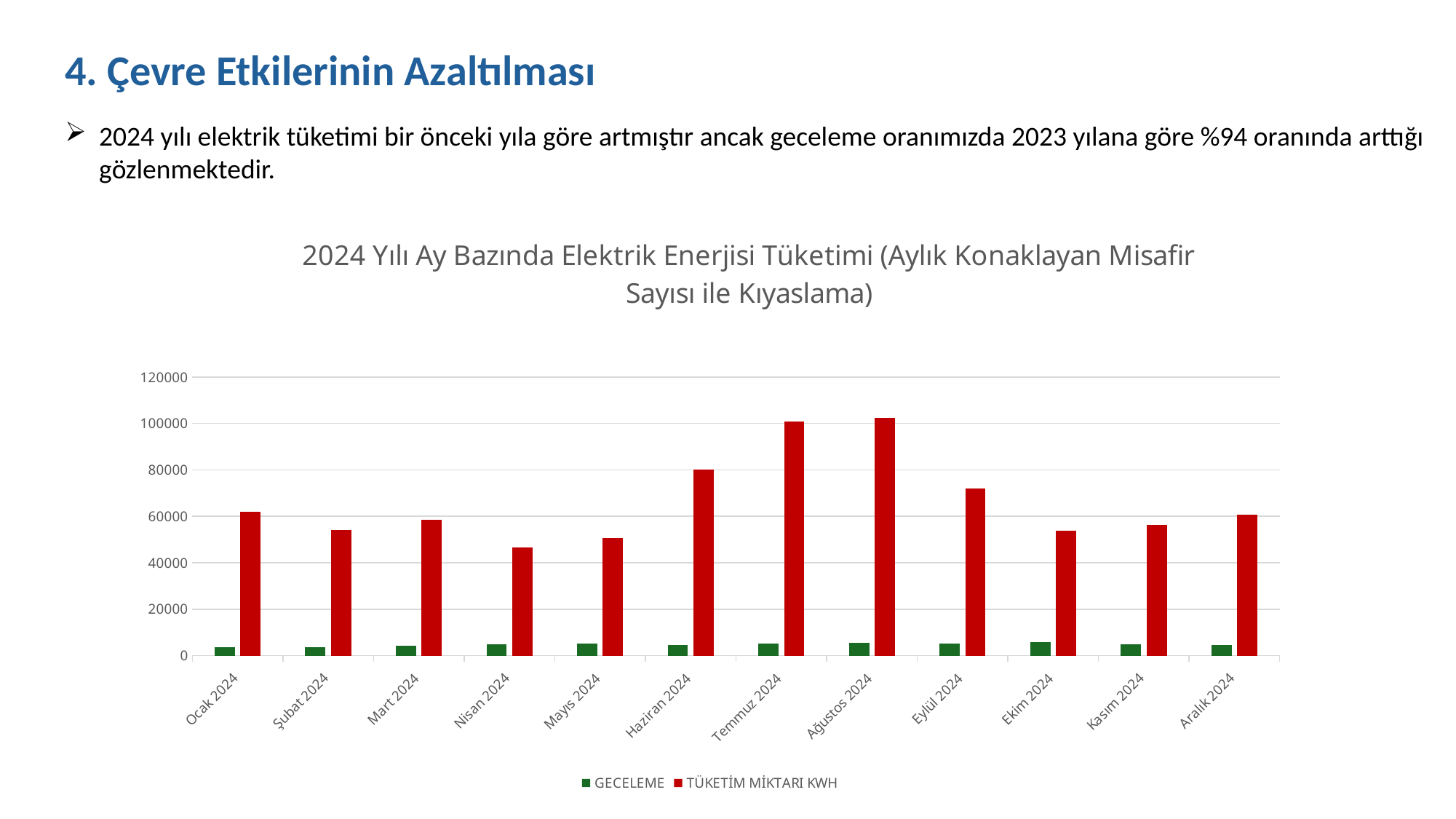
Which month has the highest TÜKETİM MİKTARI KWH value? Ağustos 2024 What are the two series named in the chart's legend? GECELEME and TÜKETİM MİKTARI KWH Is the TÜKETİM MİKTARI KWH value for Temmuz 2024 greater or less than 80000? greater Which month has the lowest TÜKETİM MİKTARI KWH value? Nisan 2024 What kind of chart is shown on the slide? Bar chart Is the TÜKETİM MİKTARI KWH value for Haziran 2024 greater or less than 60000? greater Is the TÜKETİM MİKTARI KWH value for Nisan 2024 greater or less than 60000? less What colour are the TÜKETİM MİKTARI KWH bars in the chart? Red Which is larger, the TÜKETİM MİKTARI KWH value for Haziran 2024 or for Eylül 2024? Haziran 2024 How many series does the chart's legend list? 2 How many months (categories) are shown on the x axis of the chart? 12 Does the TÜKETİM MİKTARI KWH value rise or fall from Nisan 2024 to Ağustos 2024? Rise